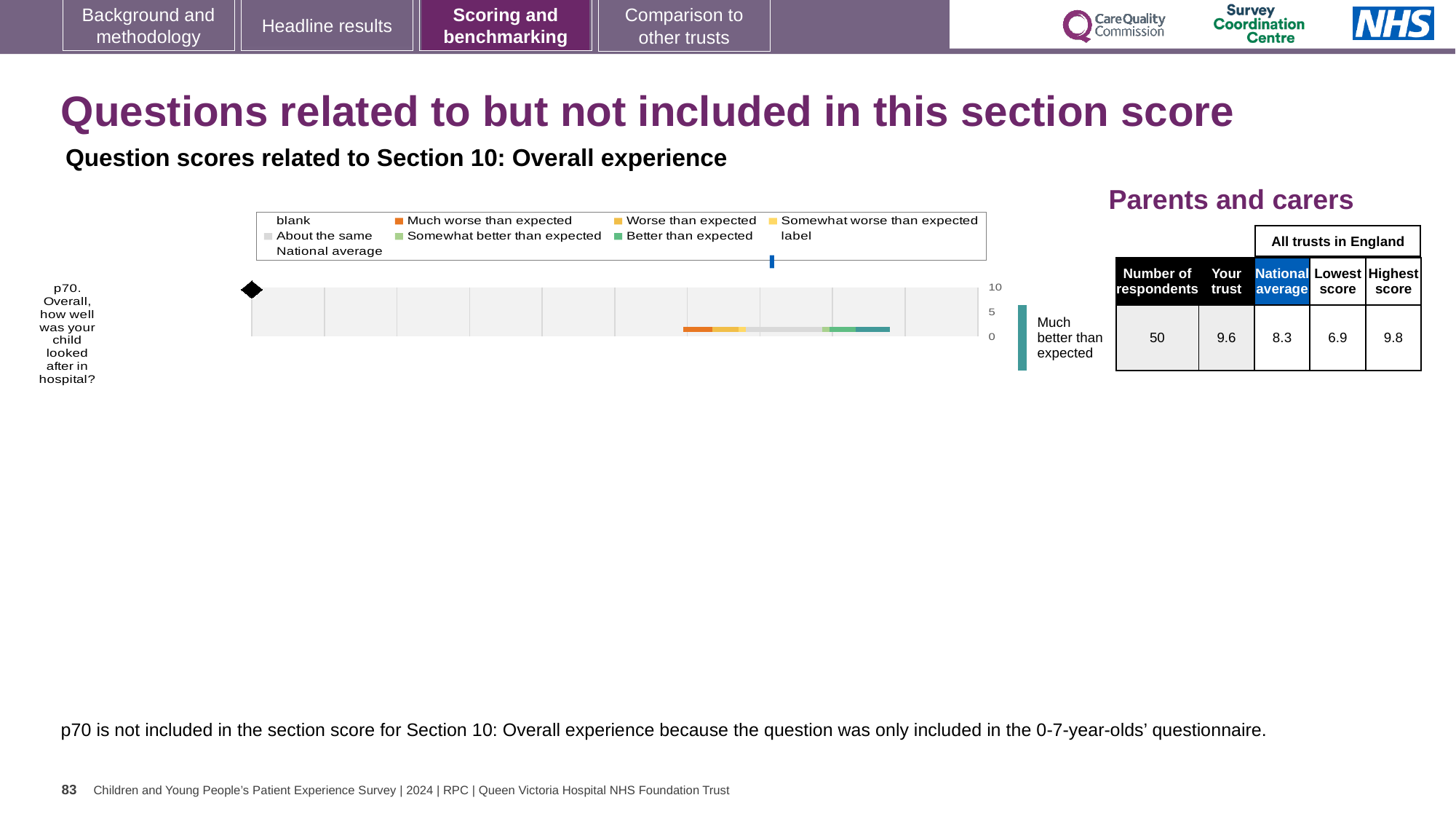
Which question is plotted in the chart? p70. Overall, how well was your child looked after in hospital? What kind of chart is used to show the p70 question score? bar chart What is the number of respondents for p70? 50 What is the lowest score among all trusts in England for p70? 6.9 What is the 'Your trust' score for p70? 9.6 What is the difference between the highest and lowest scores among all trusts in England for p70? 2.9 What is the benchmark category shown next to the chart for p70? Much better than expected What is the highest score among all trusts in England for p70? 9.8 Which is larger for p70, the 'Your trust' score or the national average? Your trust How many questions are plotted in the chart? 1 What is the national average score for p70? 8.3 What is the difference between the 'Your trust' score and the national average for p70? 1.3